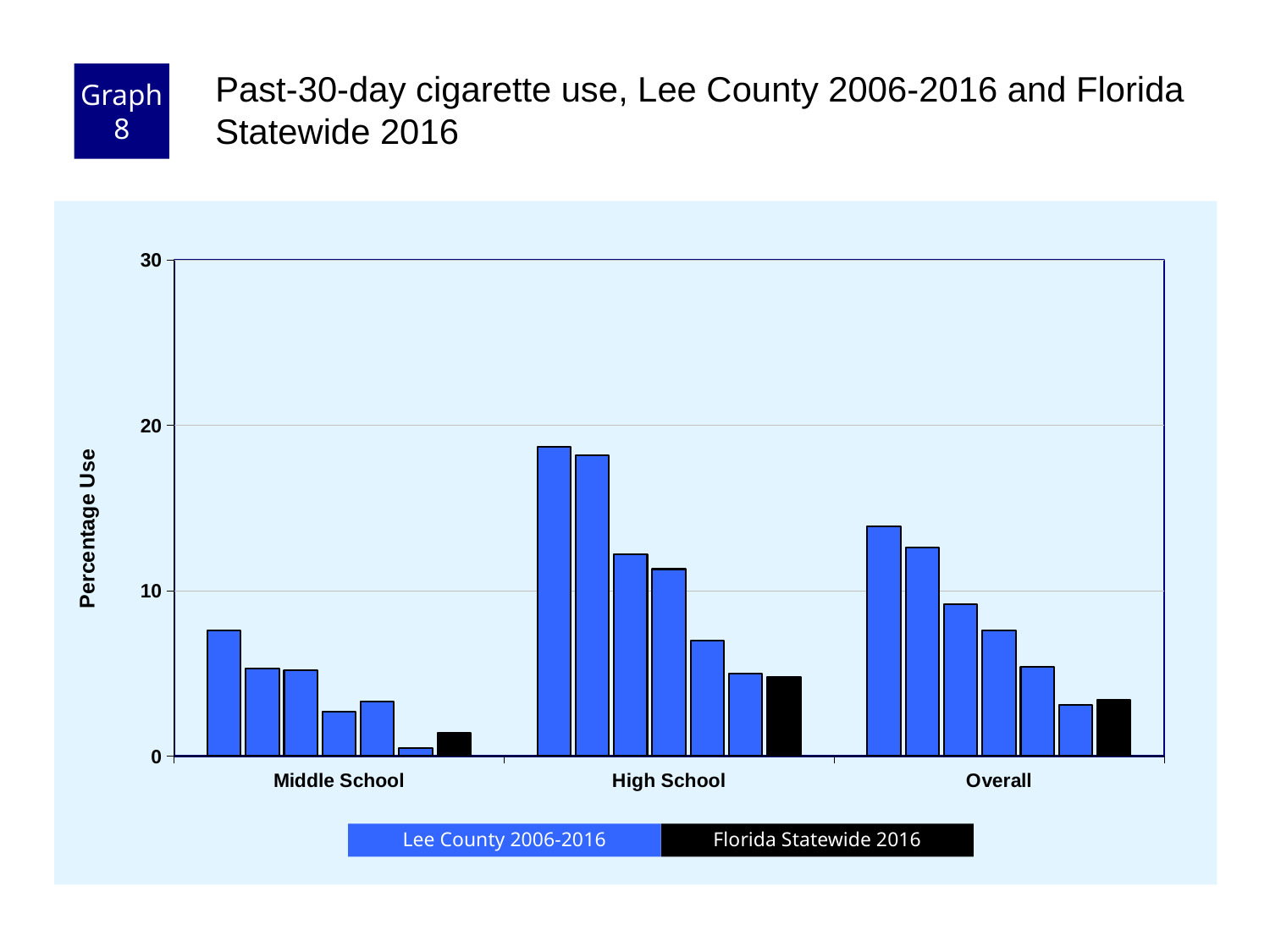
Is the tallest Lee County bar for High School greater or less than 20? less Is the Florida Statewide 2016 value for High School greater or less than 10? less Which category has the lowest bars overall? Middle School Is the tallest Lee County bar for Overall greater or less than 10? greater What kind of chart is shown on the slide? bar chart Do the Lee County 2006-2016 bars within the High School group rise or fall from left to right? fall What is the label on the y axis? Percentage Use How many categories are shown on the x axis? 3 Which is larger, the Florida Statewide 2016 bar for High School or the Florida Statewide 2016 bar for Middle School? High School Which category has the tallest bar overall? High School How many series does the legend list? 2